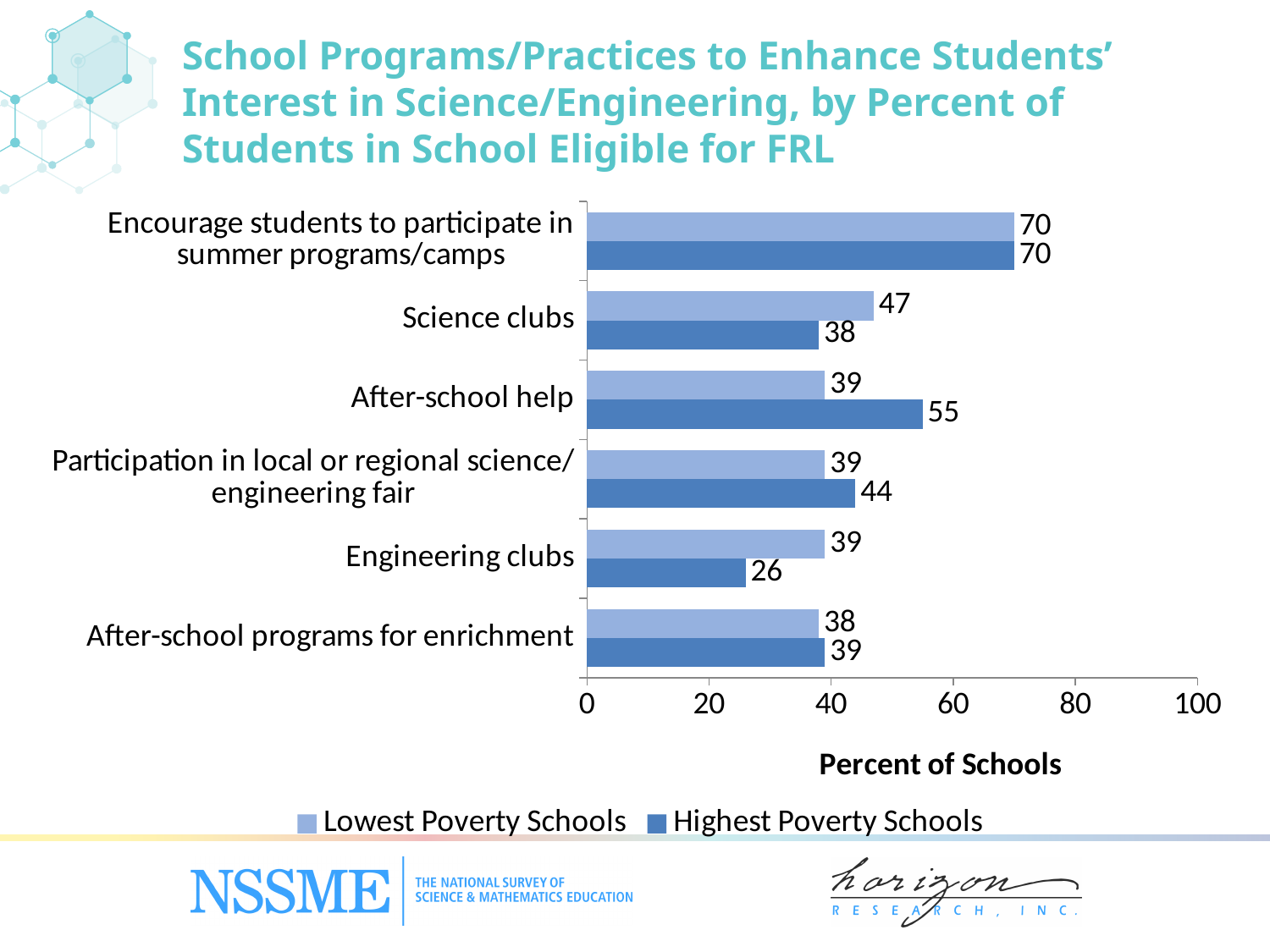
What is the difference between the Lowest Poverty Schools and Highest Poverty Schools values for After-school help? 16 What is the value for Engineering clubs for Highest Poverty Schools? 26 Which category has the lowest value for Highest Poverty Schools? Engineering clubs What is the label of the horizontal axis? Percent of Schools How many series does the legend list? 2 What kind of chart is shown on the slide? Bar chart Which category has the highest value for Highest Poverty Schools? Encourage students to participate in summer programs/camps What is the value for Science clubs for Lowest Poverty Schools? 47 For Science clubs, which is larger: the value for Lowest Poverty Schools or Highest Poverty Schools? Lowest Poverty Schools How many categories are shown on the chart? 6 What is the difference between the Lowest Poverty Schools and Highest Poverty Schools values for Engineering clubs? 13 What is the value for After-school help for Highest Poverty Schools? 55